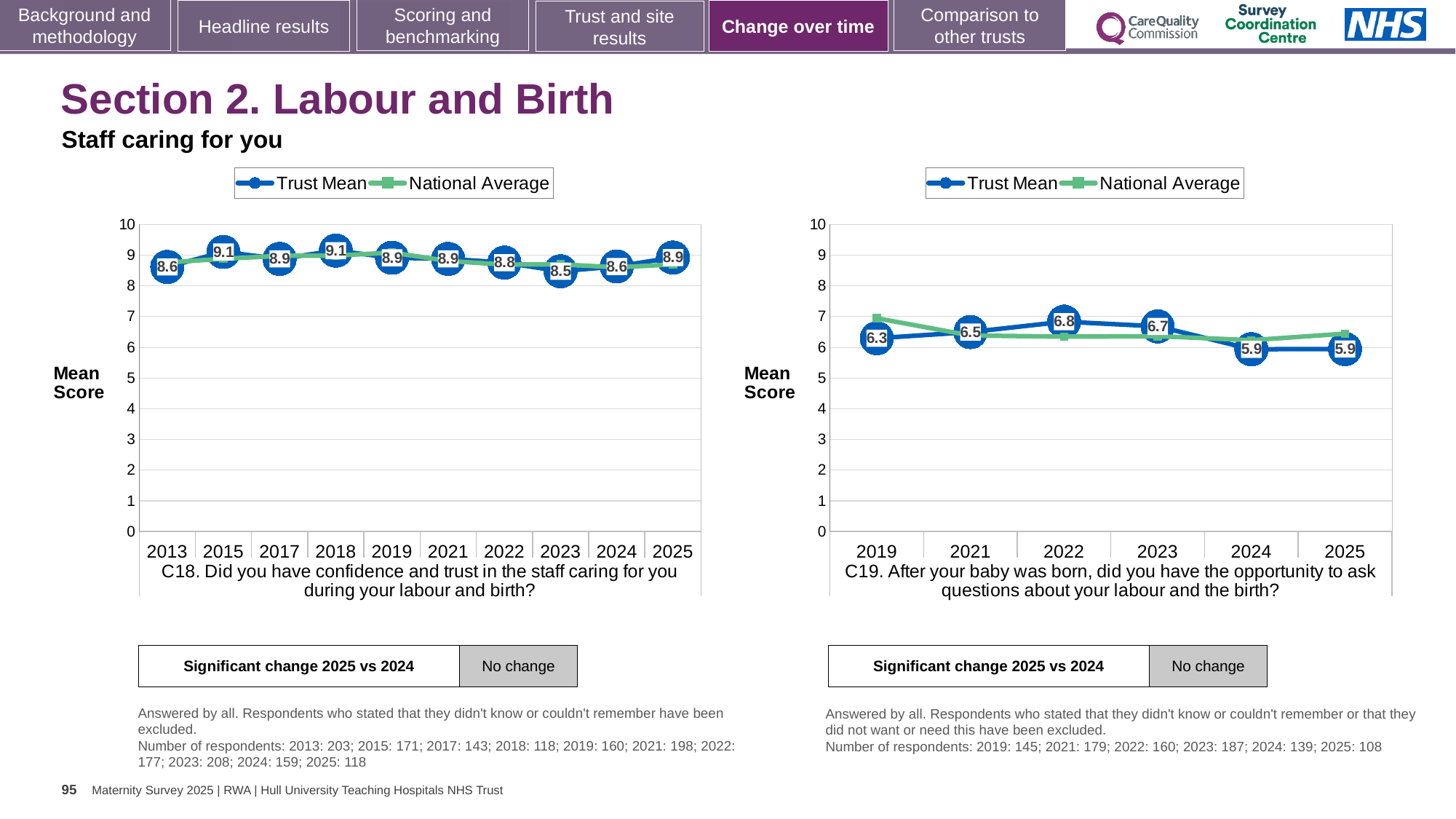
In the C18 chart on the left, what is the Trust Mean score for 2025? 8.9 In the C18 chart on the left, what is the Trust Mean score for 2013? 8.6 In the C19 chart on the right, is the National Average value for 2019 greater or less than 6? greater In the C18 chart on the left, how many years are plotted on the x axis? 10 In the C19 chart on the right, is the Trust Mean score higher in 2019 or in 2023? 2023 How many series does the legend of the C19 chart on the right list? 2 In the C19 chart on the right, what is the Trust Mean score for 2022? 6.8 In the C19 chart on the right, does the Trust Mean score rise or fall from 2023 to 2025? fall In the C18 chart on the left, what is the difference between the Trust Mean scores for 2018 and 2023? 0.6 In the C19 chart on the right, what is the difference between the Trust Mean scores for 2022 and 2024? 0.9 In the C19 chart on the right, which year has the highest Trust Mean score? 2022 In the C18 chart on the left, which year has the lowest Trust Mean score? 2023